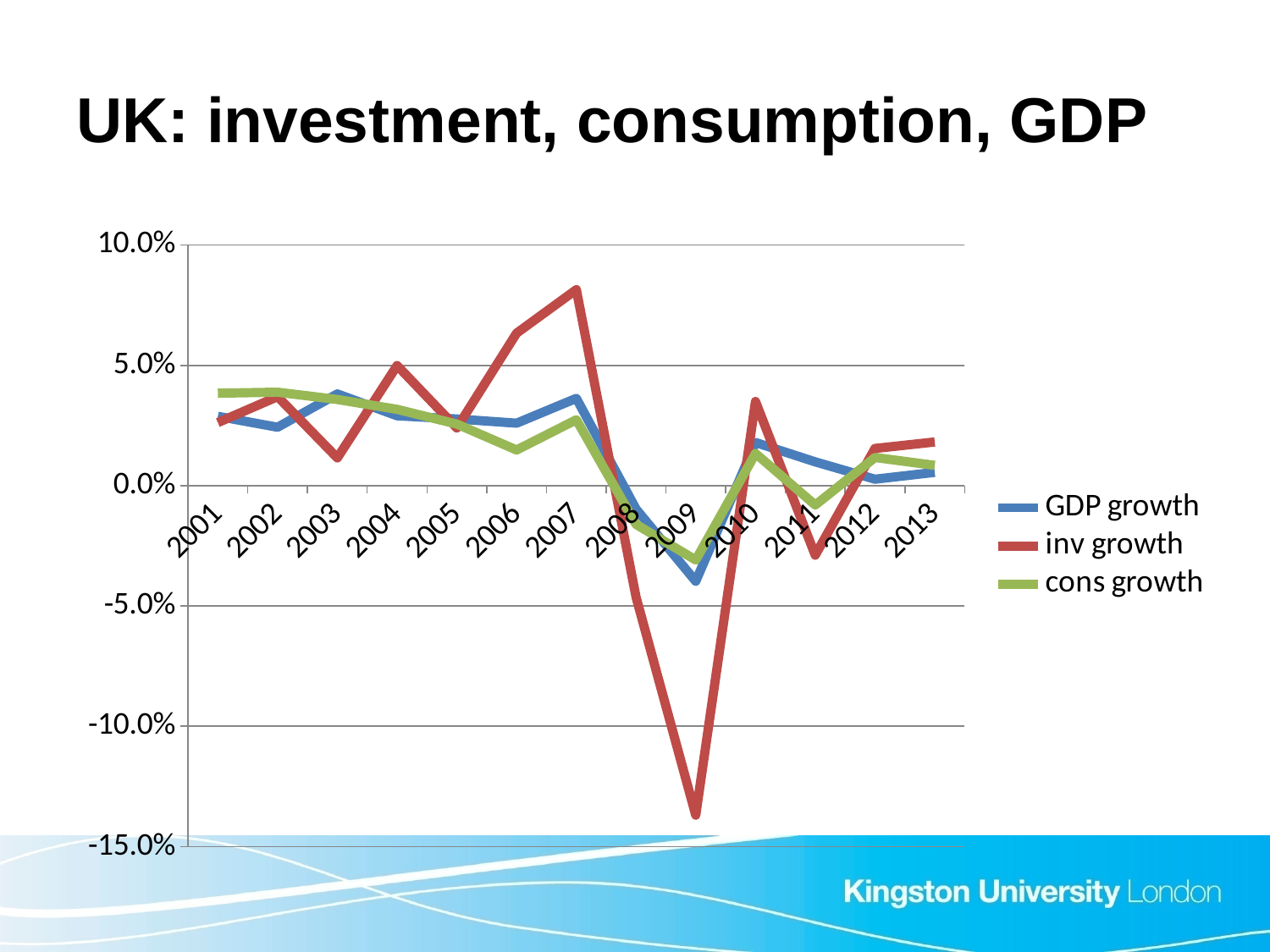
Does inv growth rise or fall from 2007 to 2009? fall Is the value for inv growth in 2009 greater or less than -10.0%? less In which year does inv growth reach its lowest value? 2009 What kind of chart is shown on the slide? line chart Is the value for GDP growth in 2009 greater or less than 0.0%? less Which series reaches the lowest value on the chart? inv growth Is the value for inv growth in 2007 greater or less than 5.0%? greater In which year does inv growth reach its highest value? 2007 How many series does the legend list? 3 Which colour is used for the inv growth line? red How many years are plotted along the x axis? 13 In 2009, which is lower, inv growth or GDP growth? inv growth